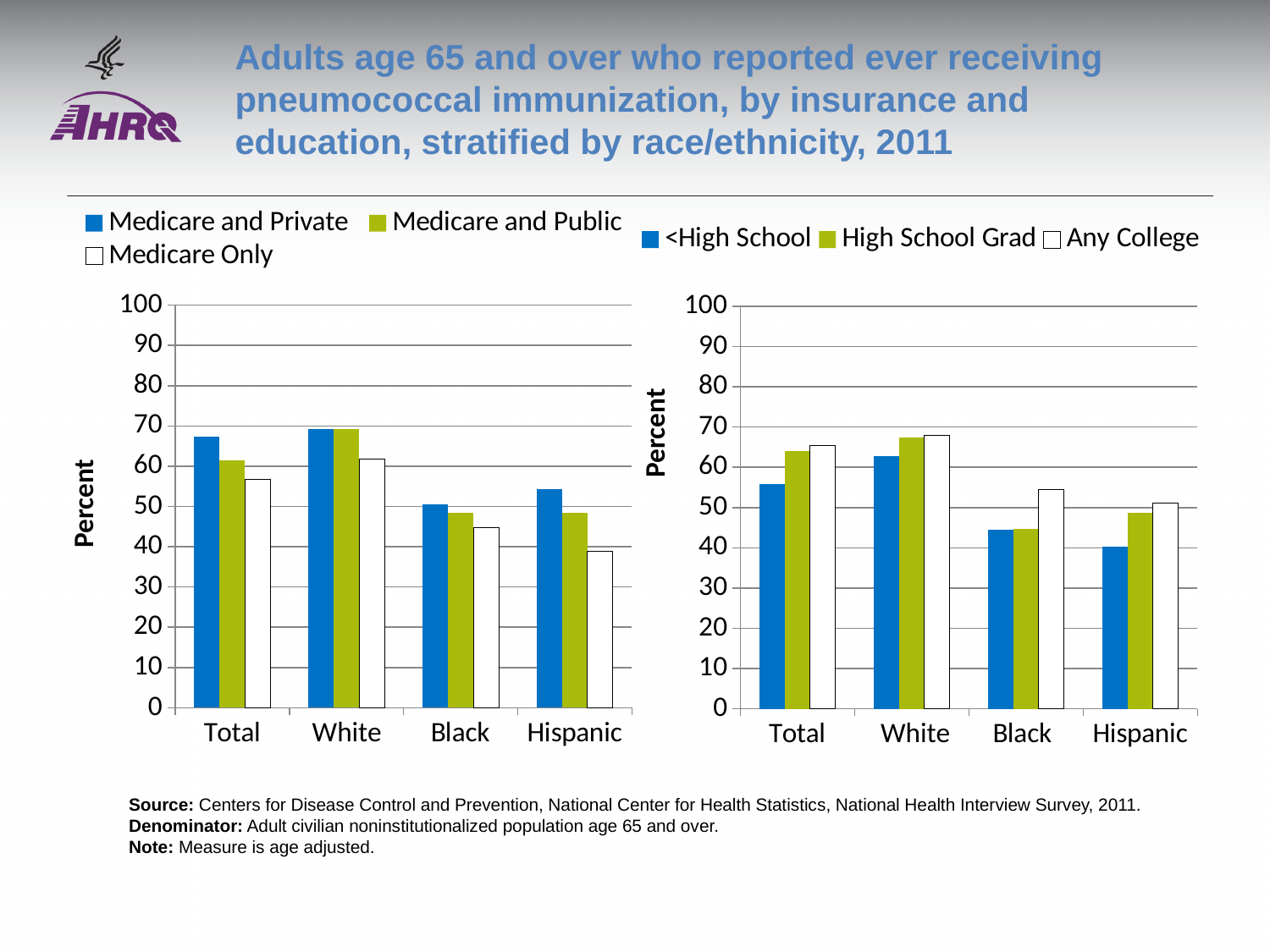
In the right chart (by education), which is larger for Black: Any College or <High School? Any College In the right chart (by education), is the value for Any College for Total greater or less than 60? greater In the right chart (by education), which category has the lowest <High School value? Hispanic In the left chart (by insurance), is the value for Medicare and Private for White greater or less than 60? greater How many series does the legend of the left chart (by insurance) list? 3 In the left chart (by insurance), which category has the lowest Medicare Only value? Hispanic What kind of chart is the left chart (by insurance)? bar chart In the left chart (by insurance), is the value for Medicare Only for Hispanic greater or less than 50? less How many series does the legend of the right chart (by education) list? 3 In the left chart (by insurance), which is larger for Hispanic: Medicare and Private or Medicare Only? Medicare and Private How many race/ethnicity categories are shown on the x axis of the right chart (by education)? 4